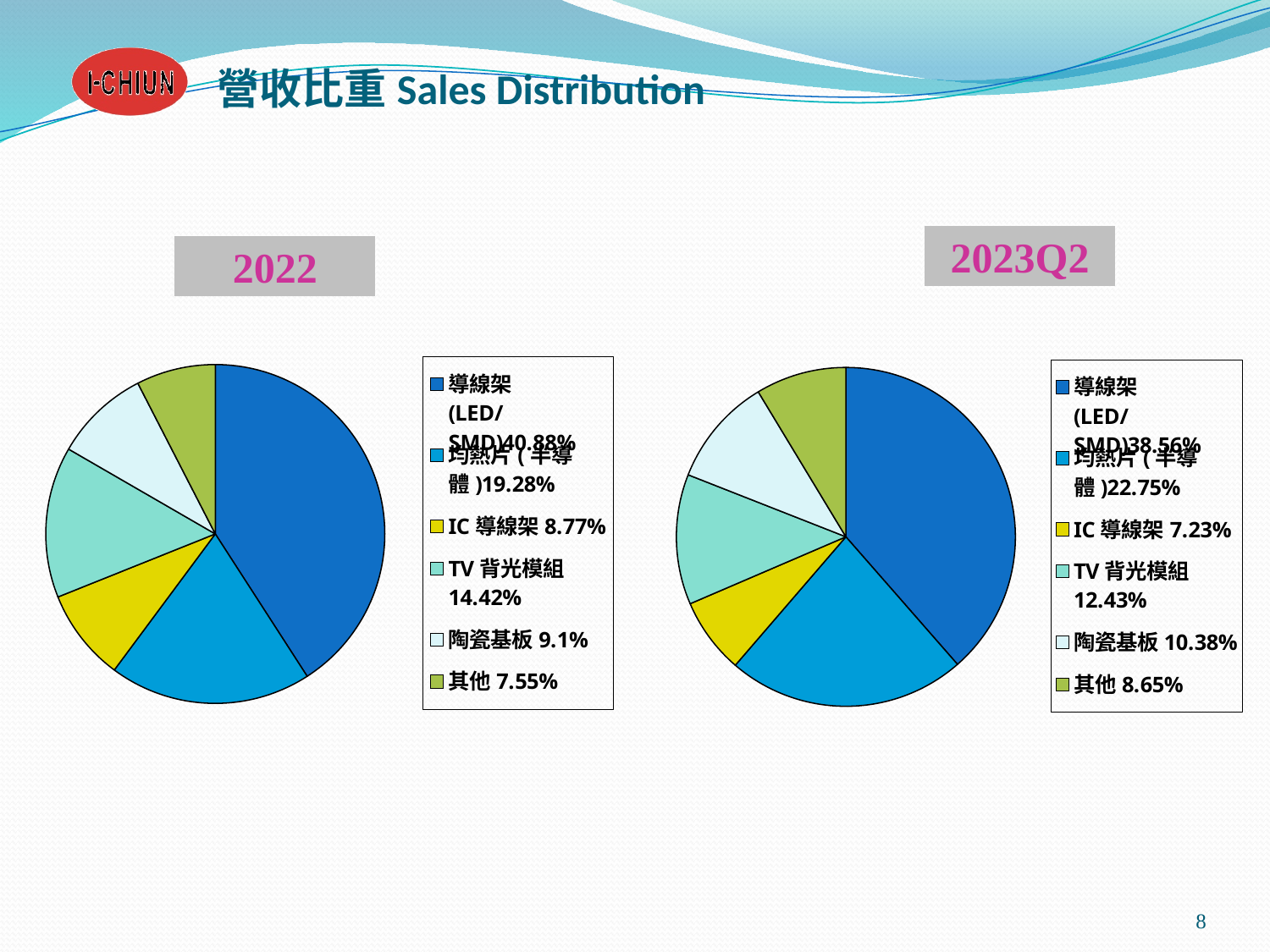
In the 2023Q2 pie chart, which category has the smallest share? IC 導線架 In the 2023Q2 pie chart, which is larger: TV 背光模組 or 陶瓷基板? TV 背光模組 In the 2022 pie chart, what is the share for IC 導線架? 8.77% In the 2023Q2 pie chart, what is the share for 陶瓷基板? 10.38% In the 2022 pie chart, which category has the largest share? 導線架(LED/SMD) What is the difference between the 導線架(LED/SMD) share in the 2022 pie chart and in the 2023Q2 pie chart? 2.32% In the 2022 pie chart, what is the share for TV 背光模組? 14.42% What kind of chart is the 2022 chart on the left? pie chart In the 2023Q2 pie chart, what share does 均熱片(半導體) have? 22.75% In the 2022 pie chart, which category has the smallest share? 其他 How many categories does the legend of the 2023Q2 pie chart list? 6 In the 2022 pie chart, what share does 導線架(LED/SMD) have? 40.88%